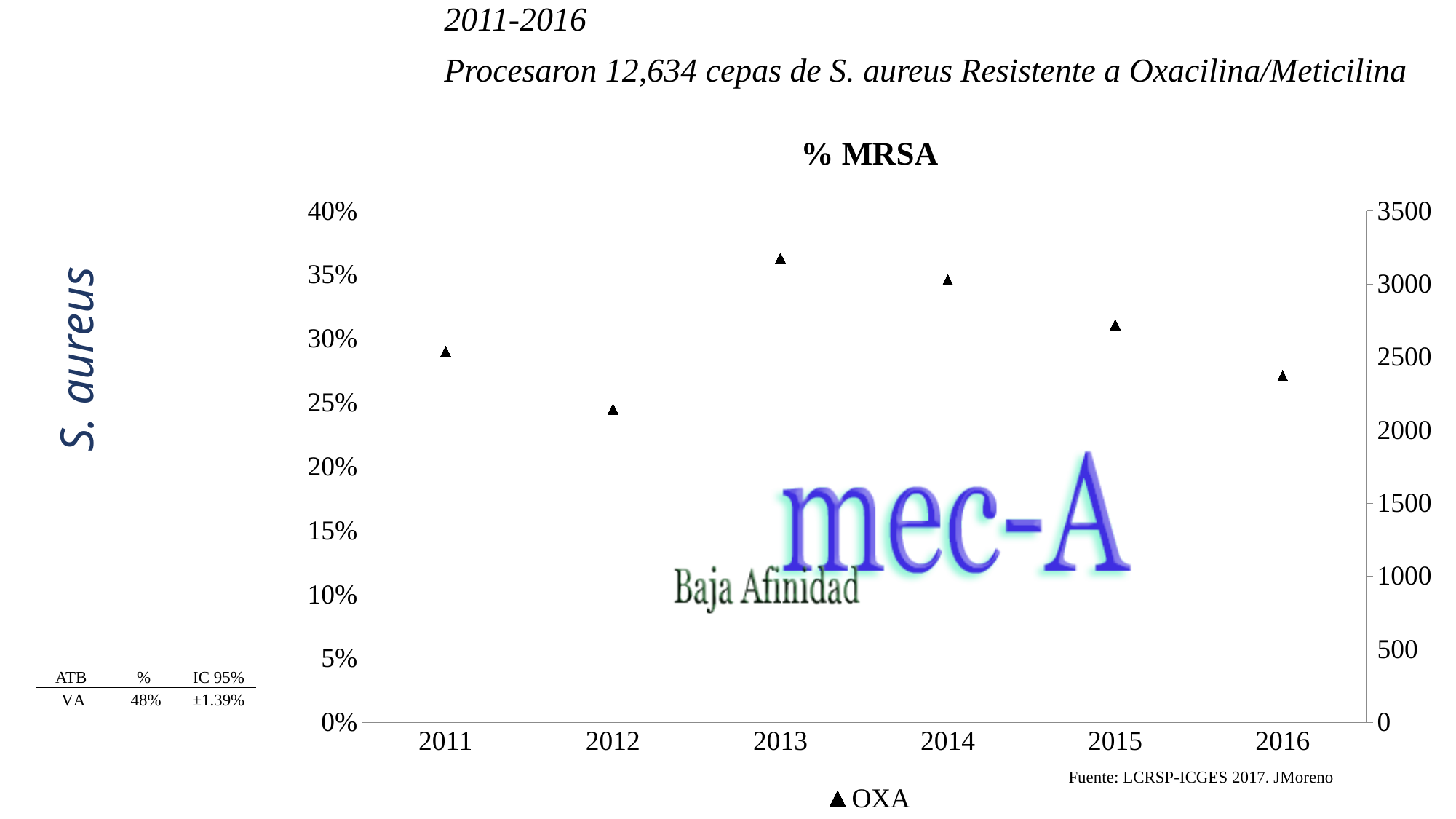
In the % MRSA chart, which year has the larger value, 2013 or 2014? 2013 In the % MRSA chart, which year has the highest value? 2013 What is the name of the series shown in the legend of the % MRSA chart? OXA In the % MRSA chart, is the value for 2012 greater or less than 30%? less In the % MRSA chart, do the values rise or fall from 2013 to 2016? fall In the % MRSA chart, which year has the lowest value? 2012 In the % MRSA chart, is the value for 2016 greater or less than 30%? less In the % MRSA chart, is the value for 2014 greater or less than 30%? greater How many years are plotted on the x axis of the % MRSA chart? 6 In the % MRSA chart, which year has the larger value, 2015 or 2016? 2015 How many series does the legend of the % MRSA chart list? 1